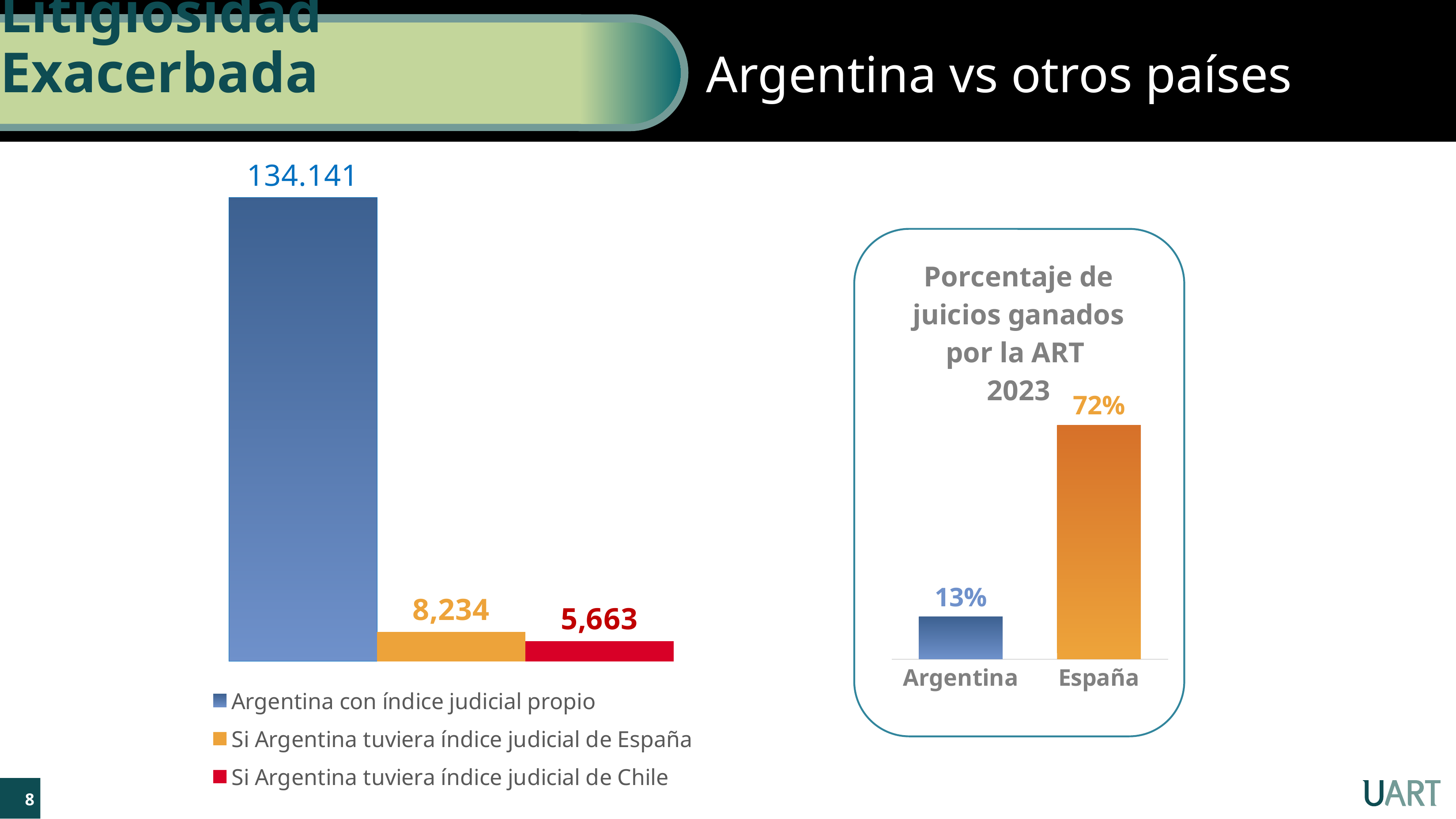
In the left chart, which series has the highest value? Argentina con índice judicial propio In the left chart, which series has the lowest value? Si Argentina tuviera índice judicial de Chile In the left chart, what is the value for 'Si Argentina tuviera índice judicial de Chile'? 5,663 In the chart 'Porcentaje de juicios ganados por la ART 2023', what is the value for Argentina? 13% What kind of chart is the left chart? Bar chart In the left chart, what is the difference between the España-index value and the Chile-index value? 2,571 In the chart 'Porcentaje de juicios ganados por la ART 2023', how many categories are shown? 2 How many series does the legend of the left chart list? 3 In the chart 'Porcentaje de juicios ganados por la ART 2023', how many percentage points higher is España than Argentina? 59 In the left chart, what is the value for 'Argentina con índice judicial propio'? 134.141 In the chart 'Porcentaje de juicios ganados por la ART 2023', what is the value for España? 72% In the left chart, what is the value for 'Si Argentina tuviera índice judicial de España'? 8,234